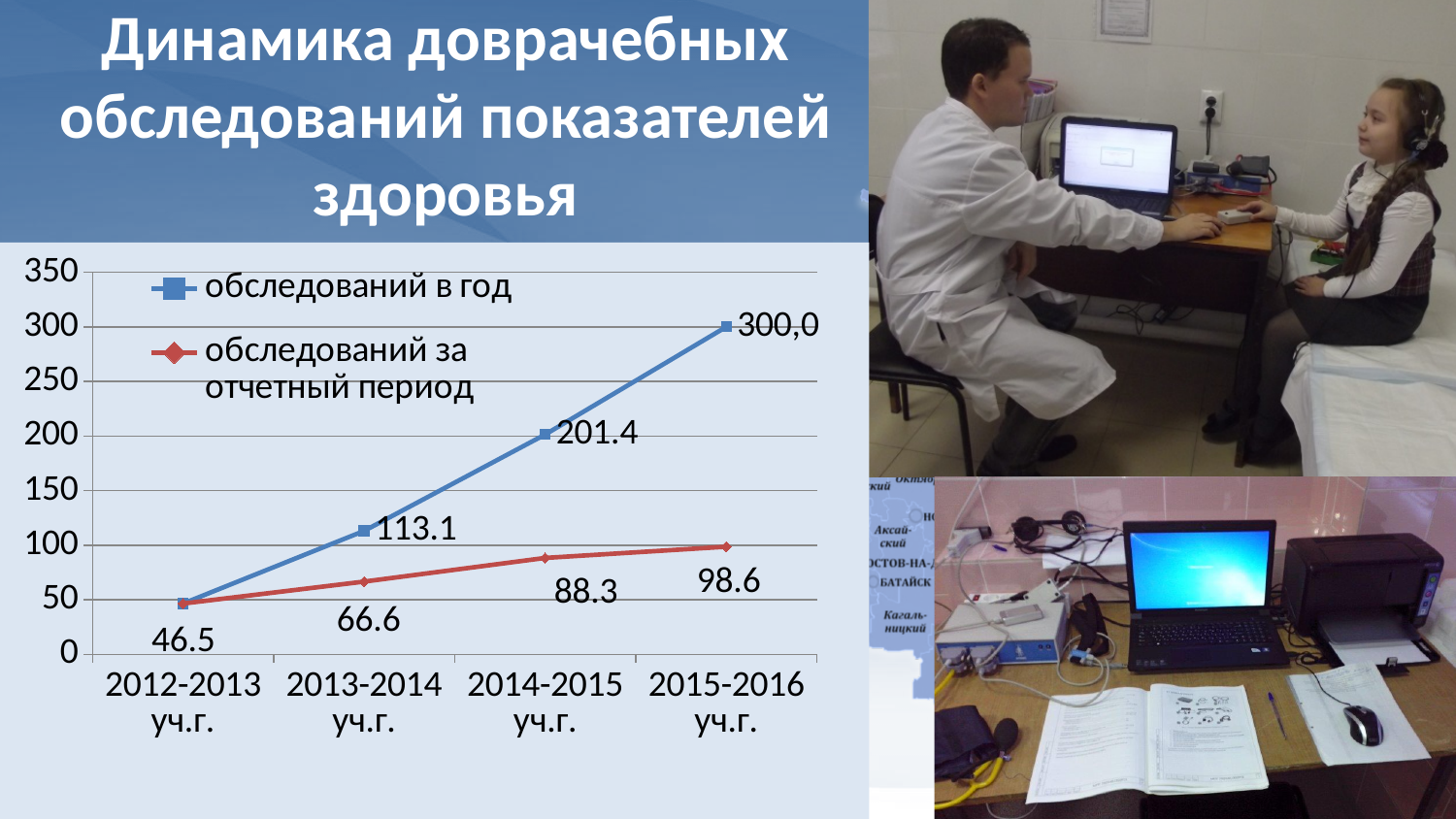
What is the value of the 'обследований в год' series for 2015-2016 уч.г.? 300,0 How many academic years are shown on the x axis of the chart? 4 What is the value of the 'обследований в год' series for 2014-2015 уч.г.? 201.4 What is the value of the 'обследований за отчетный период' series for 2015-2016 уч.г.? 98.6 What is the value of the 'обследований в год' series for 2013-2014 уч.г.? 113.1 For 2015-2016 уч.г., which series has the larger value? обследований в год What is the value of the 'обследований за отчетный период' series for 2014-2015 уч.г.? 88.3 What is the difference between the 'обследований за отчетный период' values for 2015-2016 уч.г. and 2014-2015 уч.г.? 10.3 In which academic year does the 'обследований в год' series reach its highest value? 2015-2016 уч.г. How many series does the chart legend list? 2 Is the 'обследований за отчетный период' value for 2013-2014 уч.г. greater or less than 100? less By how much did the 'обследований в год' value increase from 2013-2014 уч.г. to 2014-2015 уч.г.? 88.3